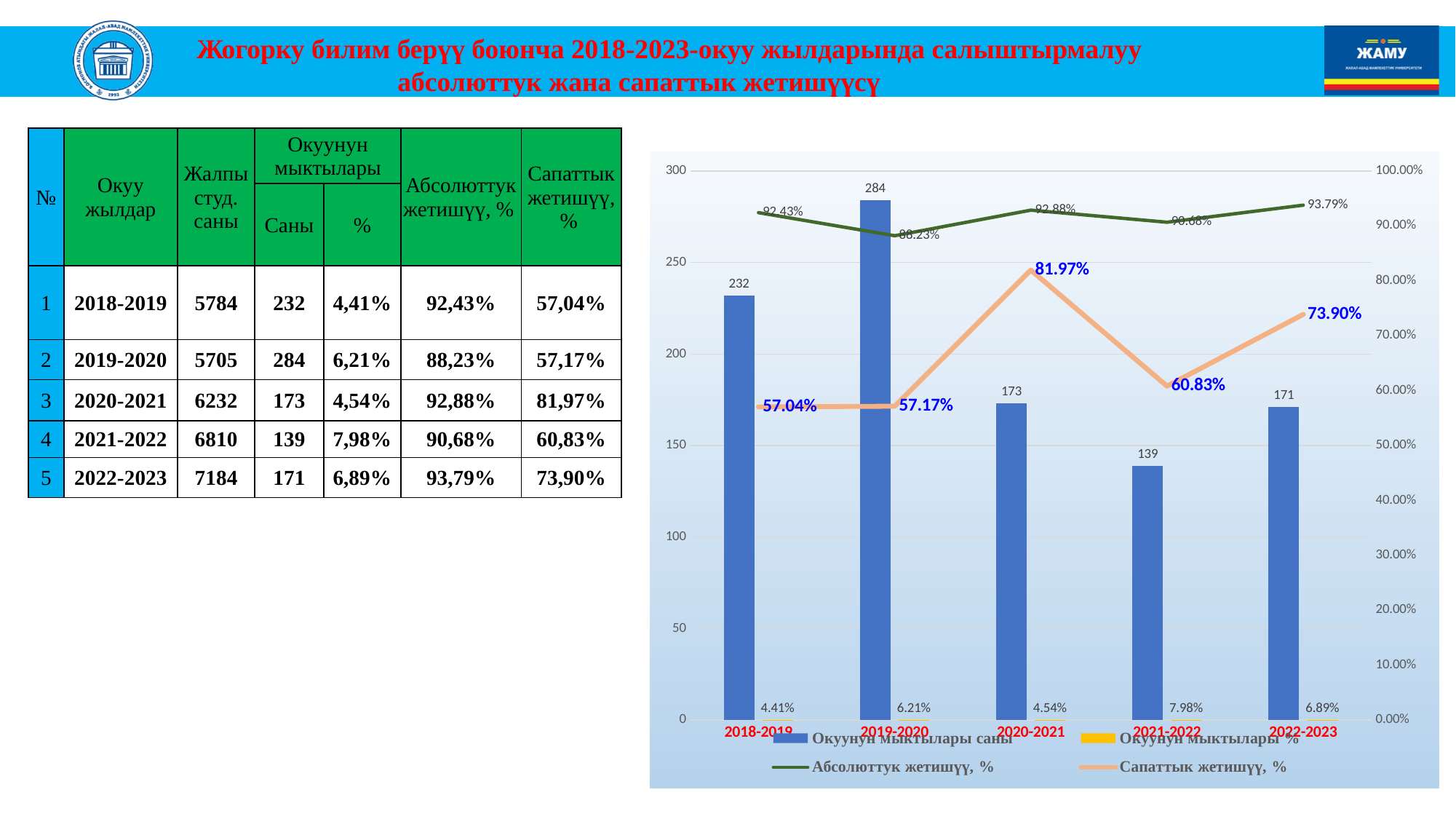
What is the 'Сапаттык жетишүү, %' value for 2020-2021? 81.97% Which academic year has the lowest 'Абсолюттук жетишүү, %' value? 2019-2020 Which academic year has the highest 'Окуунун мыктылары саны' bar? 2019-2020 What is the value of the 'Окуунун мыктылары саны' bar for 2019-2020? 284 What kind of chart is shown on the slide? Combined bar and line chart What is the 'Окуунун мыктылары %' value shown for 2021-2022? 7.98% What is the difference between the 'Окуунун мыктылары саны' bars for 2019-2020 and 2021-2022? 145 How many series does the chart legend list? 4 Which is larger, the 'Сапаттык жетишүү, %' value for 2020-2021 or for 2022-2023? 2020-2021 Which academic year has the lowest 'Окуунун мыктылары саны' bar? 2021-2022 How many academic years are shown on the x axis of the chart? 5 What is the 'Абсолюттук жетишүү, %' value for 2022-2023? 93.79%